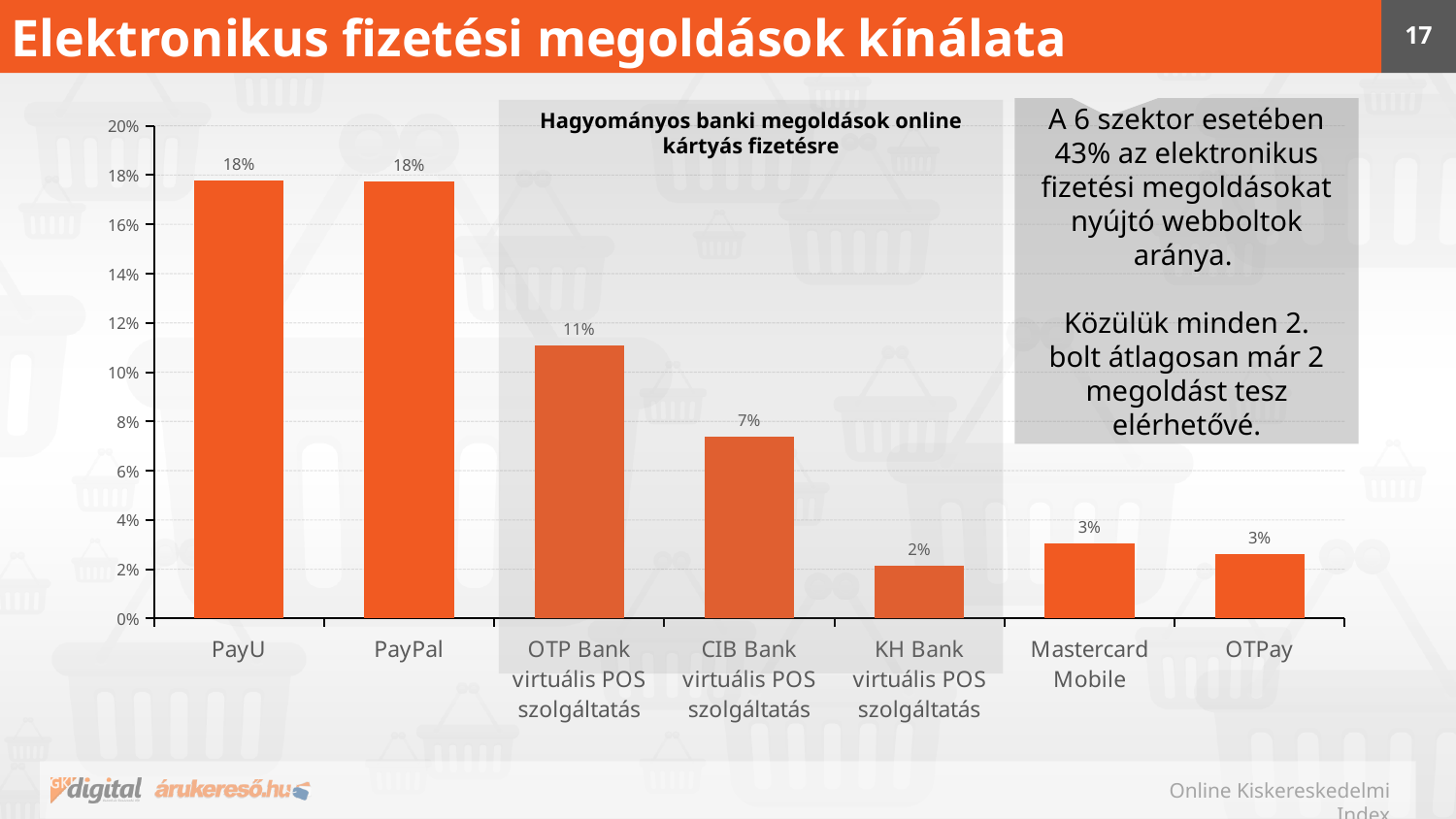
Which is larger, the value for PayPal or the value for OTP Bank virtuális POS szolgáltatás? PayPal What is the title of the slide? Elektronikus fizetési megoldások kínálata How many categories are shown on the x axis? 7 What is the value for Mastercard Mobile? 3% What is the value for OTP Bank virtuális POS szolgáltatás? 11% What is the value for PayU? 18% Is the value for CIB Bank virtuális POS szolgáltatás greater or less than 8%? less Which category has the lowest value? KH Bank virtuális POS szolgáltatás What is the difference between the values for PayU and OTPay? 15% What is the difference between the values for OTP Bank virtuális POS szolgáltatás and CIB Bank virtuális POS szolgáltatás? 4% What kind of chart is shown on the slide? bar chart What is the value for CIB Bank virtuális POS szolgáltatás? 7%